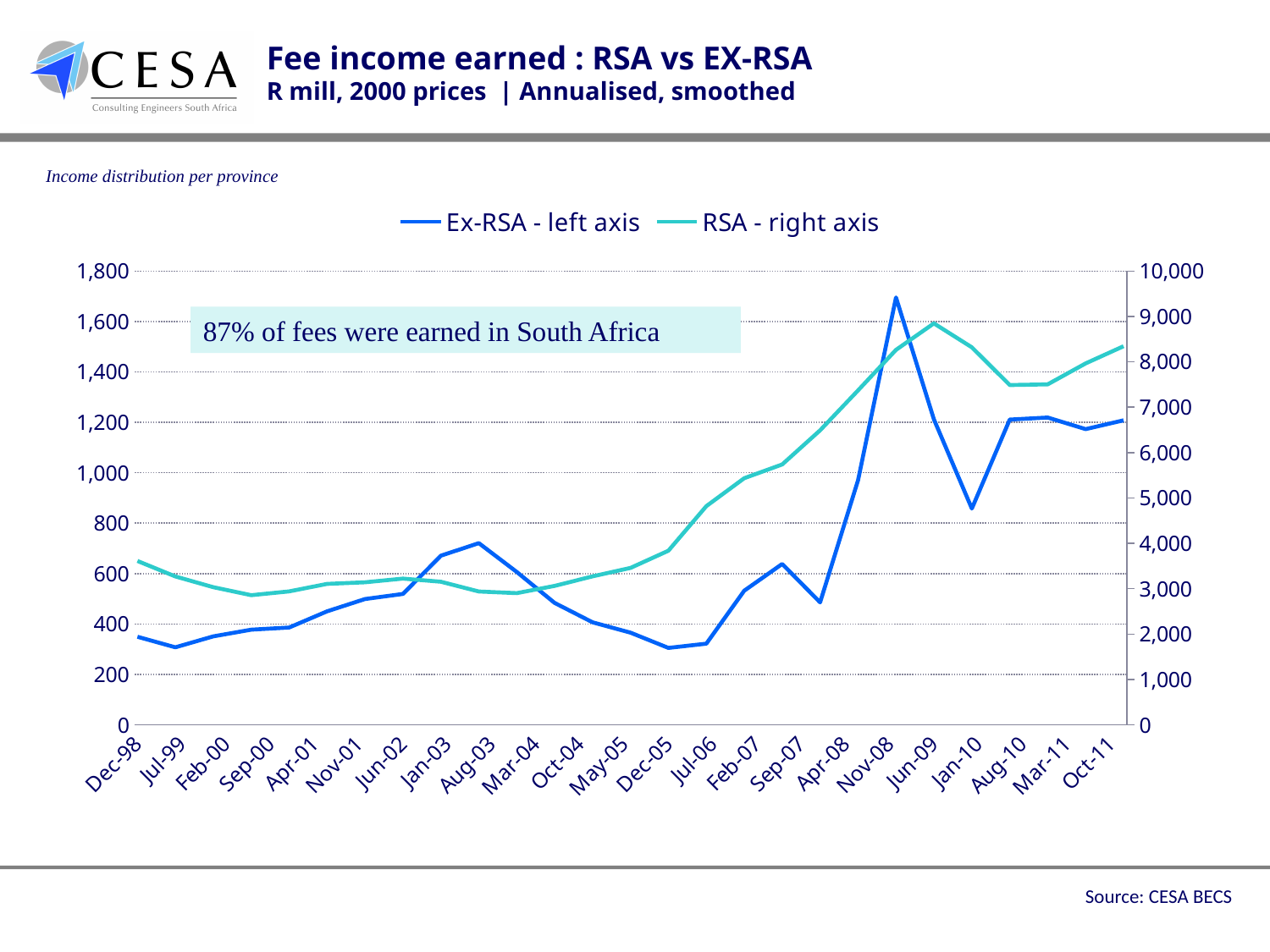
Is the Ex-RSA value at Jul-99 greater or less than 400? less What kind of chart is shown on the slide? line chart Is the Ex-RSA value at Nov-08 greater or less than 1,600? greater Which series is plotted against the right axis? RSA Is the RSA value at Jun-09 greater or less than 8,000? greater Does the RSA series rise or fall between Dec-05 and Jun-09? rise At which x-axis date does the RSA series reach its highest value? Jun-09 How many date labels are shown on the x axis? 23 How many series does the legend list? 2 What percentage of fees were earned in South Africa, according to the annotation on the chart? 87% At which x-axis date does the Ex-RSA series reach its highest value? Nov-08